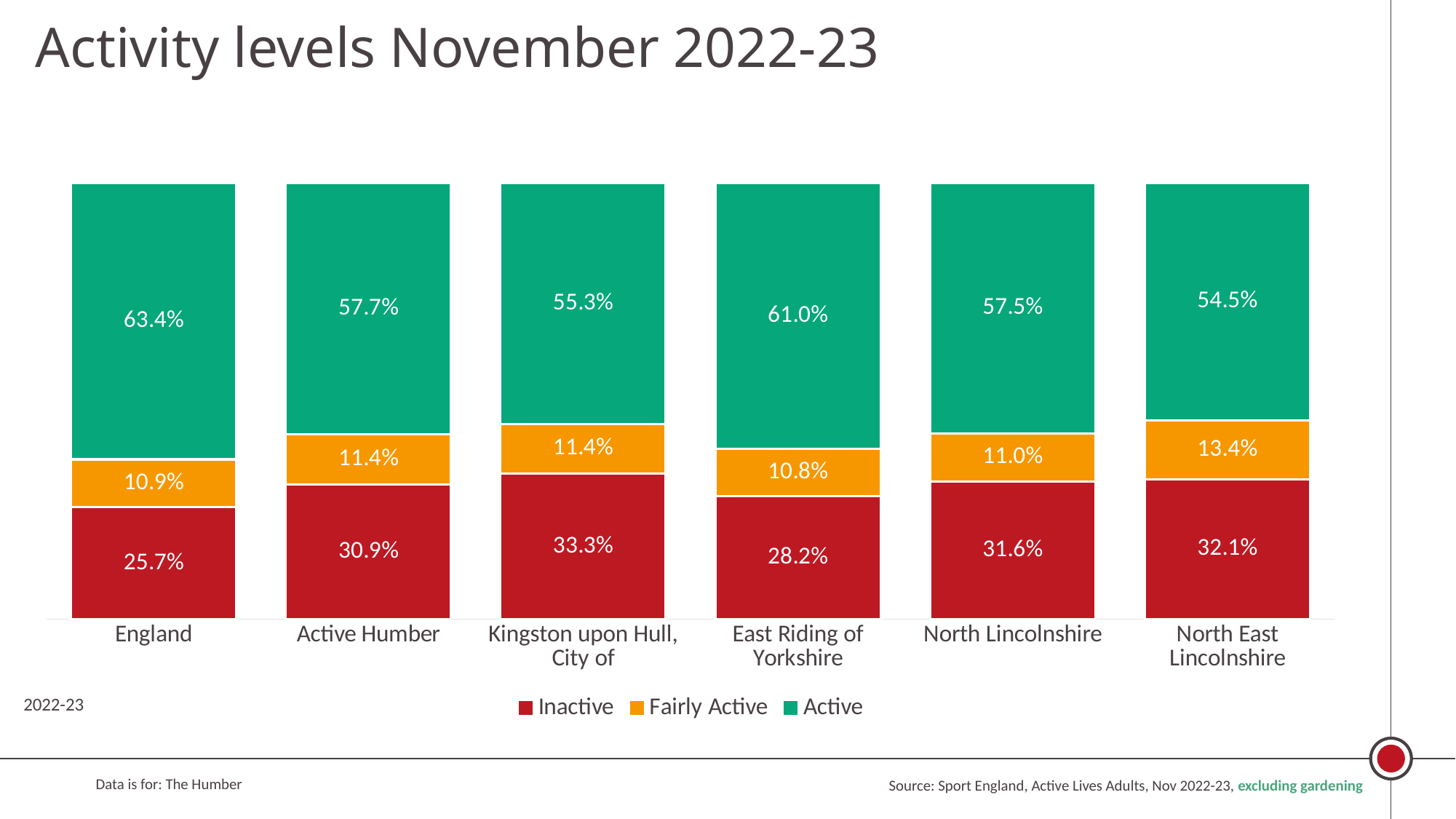
Which area has the lowest Active percentage? North East Lincolnshire What is the Active percentage for East Riding of Yorkshire? 61.0% Which has a larger Inactive percentage, Active Humber or North Lincolnshire? North Lincolnshire What is the Active percentage for England? 63.4% What is the Inactive percentage for Kingston upon Hull, City of? 33.3% How many series does the legend list? 3 Which area has the highest Inactive percentage? Kingston upon Hull, City of What kind of chart is shown on the slide? Stacked bar chart What is the difference between the Active percentage for England and for North East Lincolnshire? 8.9 percentage points How many areas are shown on the x axis? 6 Which area has the highest Active percentage? England What is the Fairly Active percentage for North East Lincolnshire? 13.4%